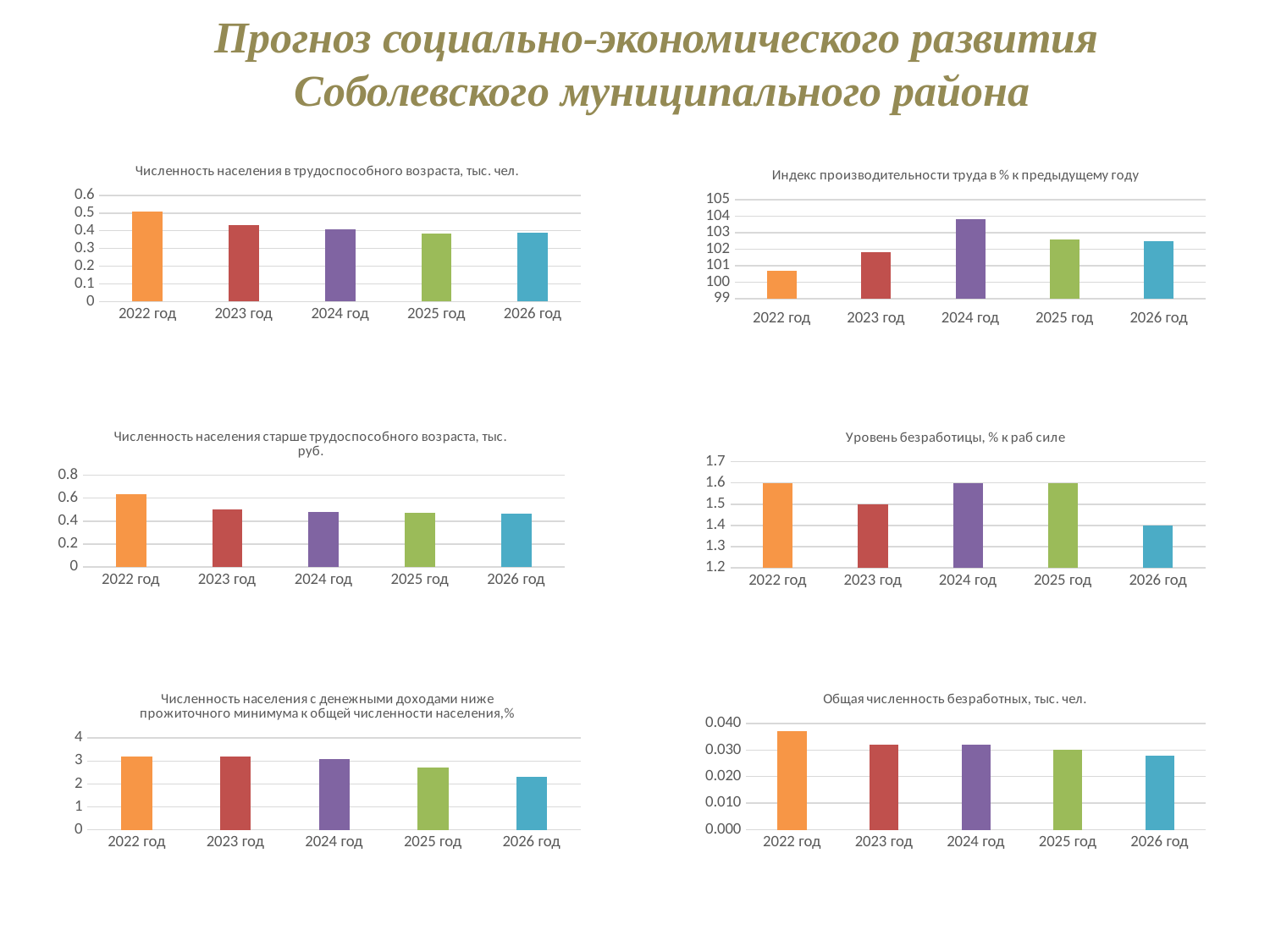
On the chart 'Индекс производительности труда в % к предыдущему году', which year has the lowest value? 2022 год On the chart 'Индекс производительности труда в % к предыдущему году', is the value for 2024 год greater or less than 103? greater On the chart 'Численность населения в трудоспособного возраста, тыс. чел.', which year has the highest value? 2022 год On the chart 'Численность населения старше трудоспособного возраста, тыс. руб.', is the value for 2022 год greater or less than 0.6? greater On the chart 'Общая численность безработных, тыс. чел.', which year has the highest value? 2022 год On the chart 'Численность населения с денежными доходами ниже прожиточного минимума к общей численности населения,%', do the values rise or fall from 2022 год to 2026 год? fall On the chart 'Уровень безработицы, % к раб силе', what is the difference between the values for 2022 год and 2026 год? 0.2 On the chart 'Уровень безработицы, % к раб силе', what is the value for 2023 год? 1.5 On the chart 'Уровень безработицы, % к раб силе', what is the value for 2026 год? 1.4 On the chart 'Индекс производительности труда в % к предыдущему году', which year has the highest value? 2024 год On the chart 'Уровень безработицы, % к раб силе', which year has the lowest value? 2026 год How many years are shown on the chart 'Общая численность безработных, тыс. чел.'? 5